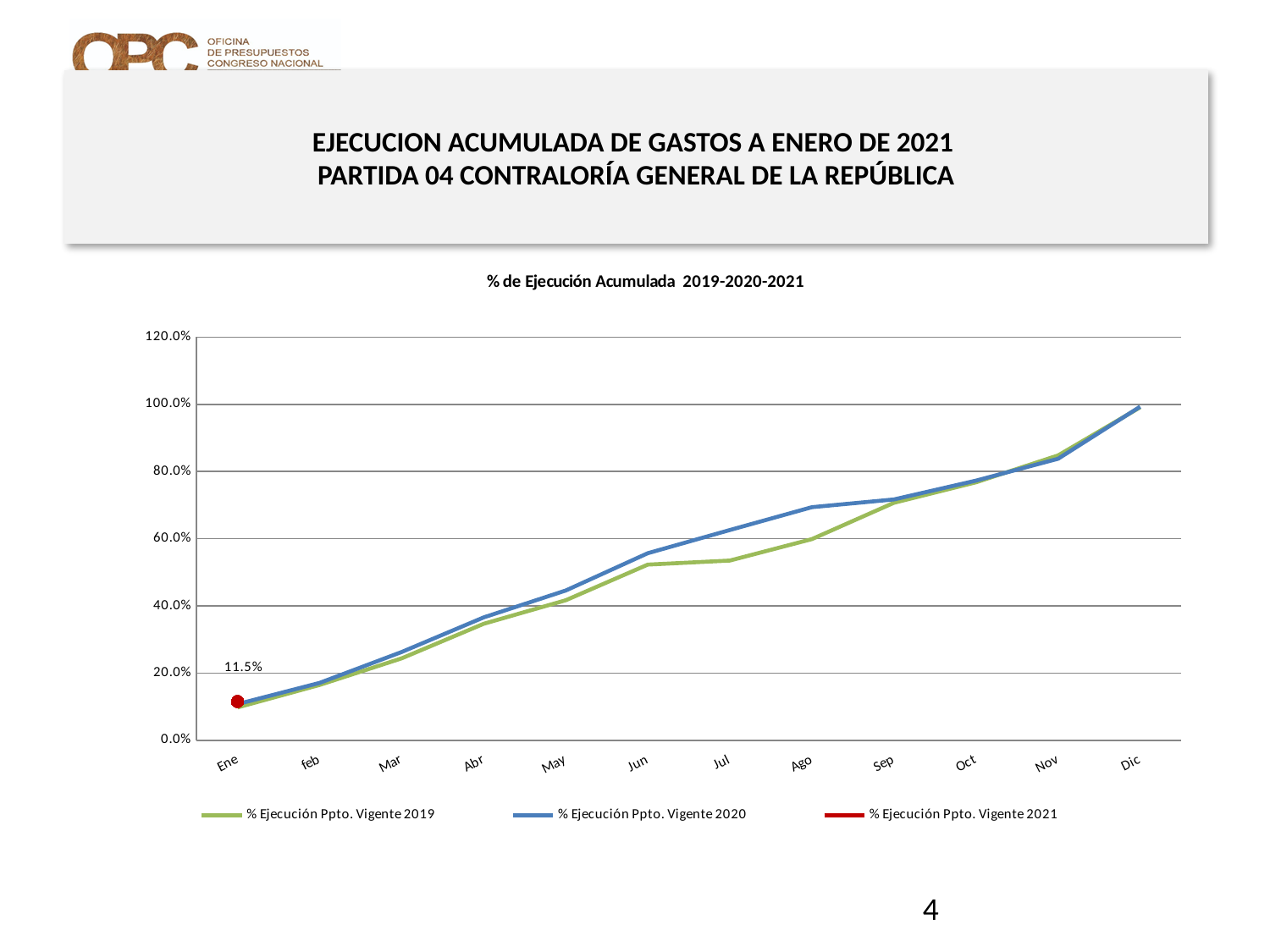
How many series does the legend list? 3 What is the title of the chart? % de Ejecución Acumulada 2019-2020-2021 Which month has the highest value for % Ejecución Ppto. Vigente 2020? Dic How many months are shown along the x axis? 12 What kind of chart is shown on the slide? line chart Is the value for % Ejecución Ppto. Vigente 2020 in Dic greater or less than 80.0%? greater In Ago, which series has the larger value: % Ejecución Ppto. Vigente 2019 or % Ejecución Ppto. Vigente 2020? % Ejecución Ppto. Vigente 2020 Do the values for % Ejecución Ppto. Vigente 2020 rise or fall from Ene to Dic? rise Is the value for % Ejecución Ppto. Vigente 2020 in Ago greater or less than 60.0%? greater Is the value for % Ejecución Ppto. Vigente 2019 in Jul greater or less than 60.0%? less What is the value of % Ejecución Ppto. Vigente 2021 for Ene? 11.5% Which month has the lowest value for % Ejecución Ppto. Vigente 2019? Ene